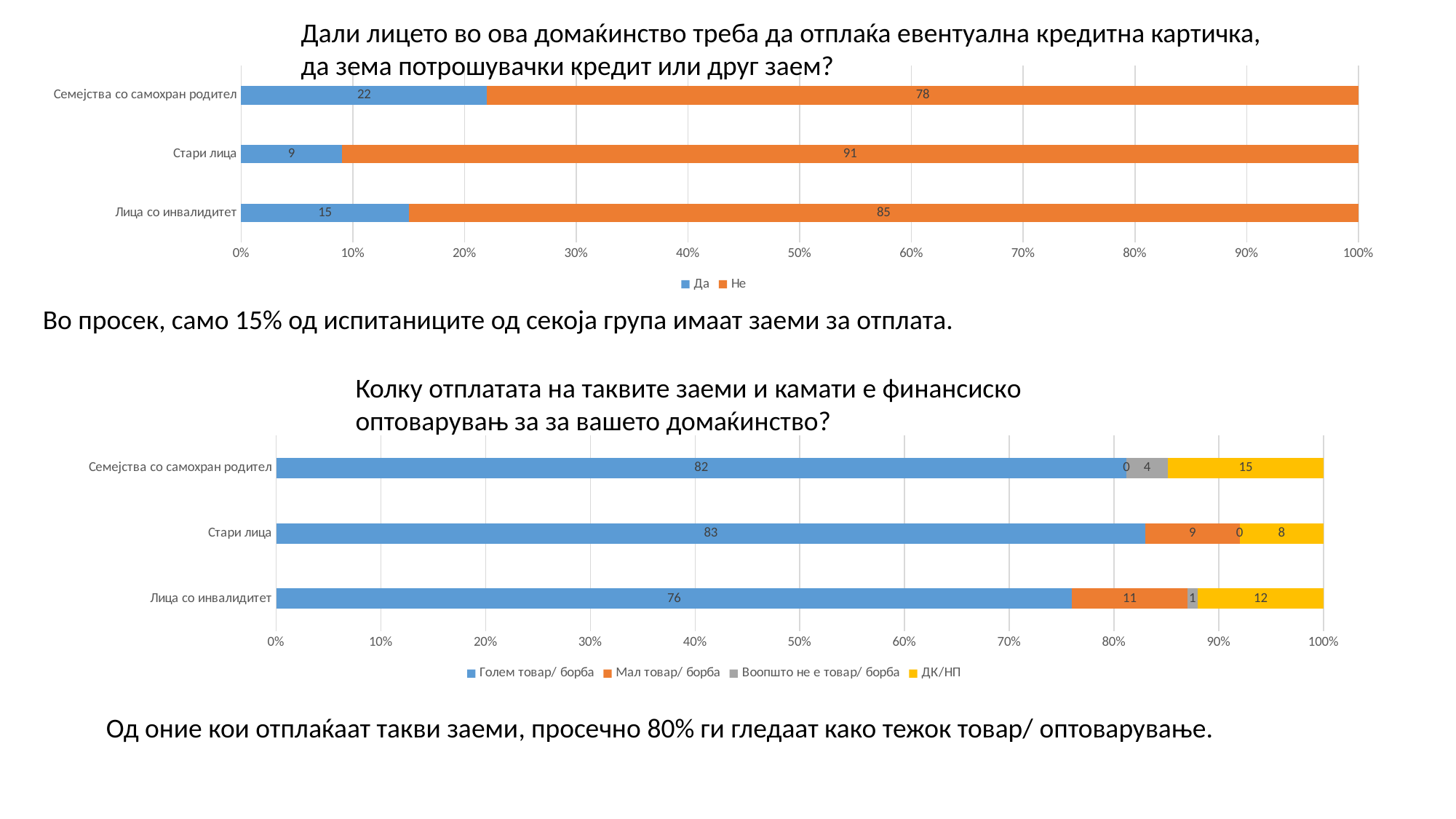
In the bottom chart, is the "Мал товар/ борба" value larger for "Стари лица" or for "Лица со инвалидитет"? Лица со инвалидитет What type of chart is the bottom chart? Stacked bar chart In the top chart, what is the value of "Да" for "Семејства со самохран родител"? 22 In the top chart, what is the value of "Не" for "Стари лица"? 91 In the bottom chart, what is the value of "ДК/НП" for "Семејства со самохран родител"? 15 In the top chart, how many series does the legend list? 2 In the bottom chart, which category has the highest value for "Голем товар/ борба"? Стари лица In the top chart, what is the difference between the "Не" values for "Стари лица" and "Семејства со самохран родител"? 13 In the top chart, which category has the lowest value for "Да"? Стари лица In the bottom chart, how many categories are shown on the vertical axis? 3 In the bottom chart, how many series does the legend list? 4 In the bottom chart, what is the value of "Голем товар/ борба" for "Лица со инвалидитет"? 76